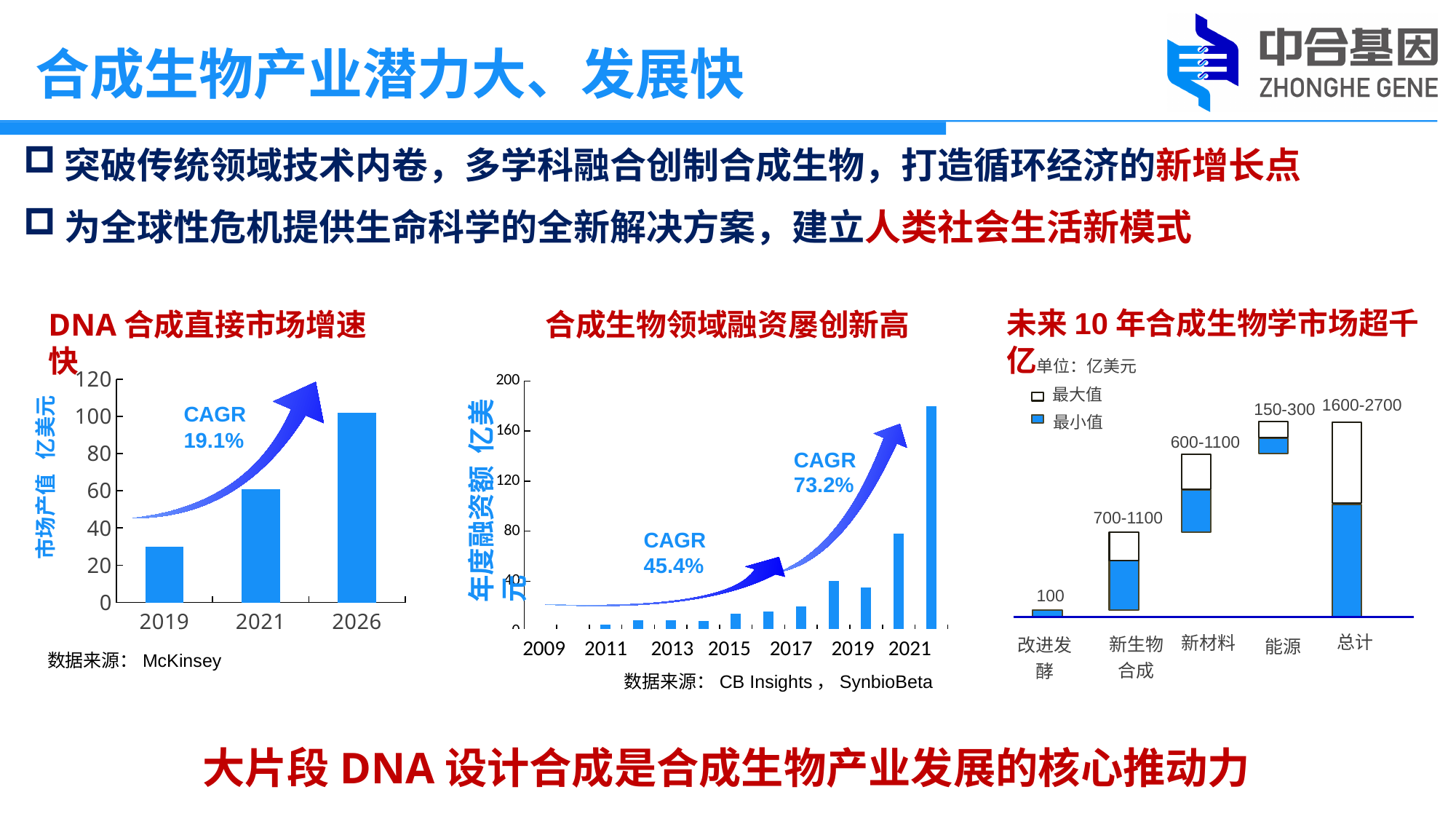
In the left chart 'DNA 合成直接市场增速快', is the value for 2026 greater or less than 80? greater In the middle chart '合成生物领域融资屡创新高', which is larger, the value for 2019 or the value for 2021? 2021 In the middle chart '合成生物领域融资屡创新高', do the values rise or fall from 2009 to 2021? rise What kind of chart is the left chart titled 'DNA 合成直接市场增速快'? bar chart In the right chart '未来10年合成生物学市场超千亿', what range is labelled for 新材料? 600-1100 In the middle chart '合成生物领域融资屡创新高', is the value for the tallest bar greater or less than 160? greater In the left chart 'DNA 合成直接市场增速快', which year has the highest bar? 2026 In the left chart 'DNA 合成直接市场增速快', is the value for 2019 greater or less than 40? less In the left chart 'DNA 合成直接市场增速快', what CAGR is printed next to the arrow? 19.1% In the left chart 'DNA 合成直接市场增速快', how many years are shown on the x axis? 3 In the right chart '未来10年合成生物学市场超千亿', how many series does the legend list? 2 In the right chart '未来10年合成生物学市场超千亿', what value is labelled for 改进发酵? 100